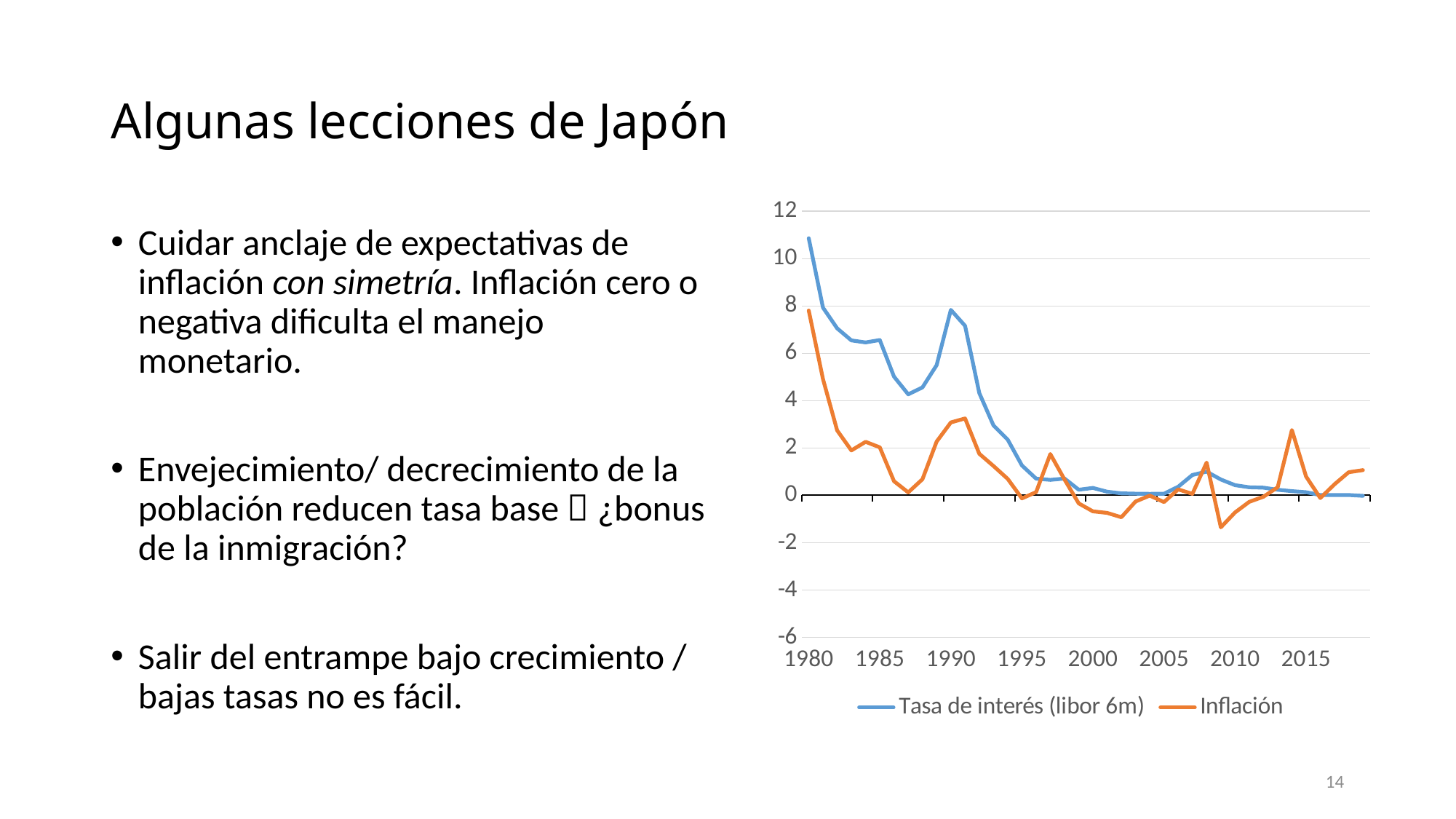
In 2014, which series has the higher value, Tasa de interés (libor 6m) or Inflación? Inflación Is the value of Tasa de interés (libor 6m) in 1980 greater or less than 10? greater What kind of chart is shown on the slide? line chart Is the value of Tasa de interés (libor 6m) in 2015 greater or less than 2? less Is the value of Inflación in 1980 greater or less than 6? greater Overall, does the Tasa de interés (libor 6m) series rise or fall from 1980 to the end of the period? fall How many series does the chart legend list? 2 Which colour is used for the Inflación series? orange In 1980, which series has the higher value, Tasa de interés (libor 6m) or Inflación? Tasa de interés (libor 6m) What are the two series named in the chart legend? Tasa de interés (libor 6m) and Inflación